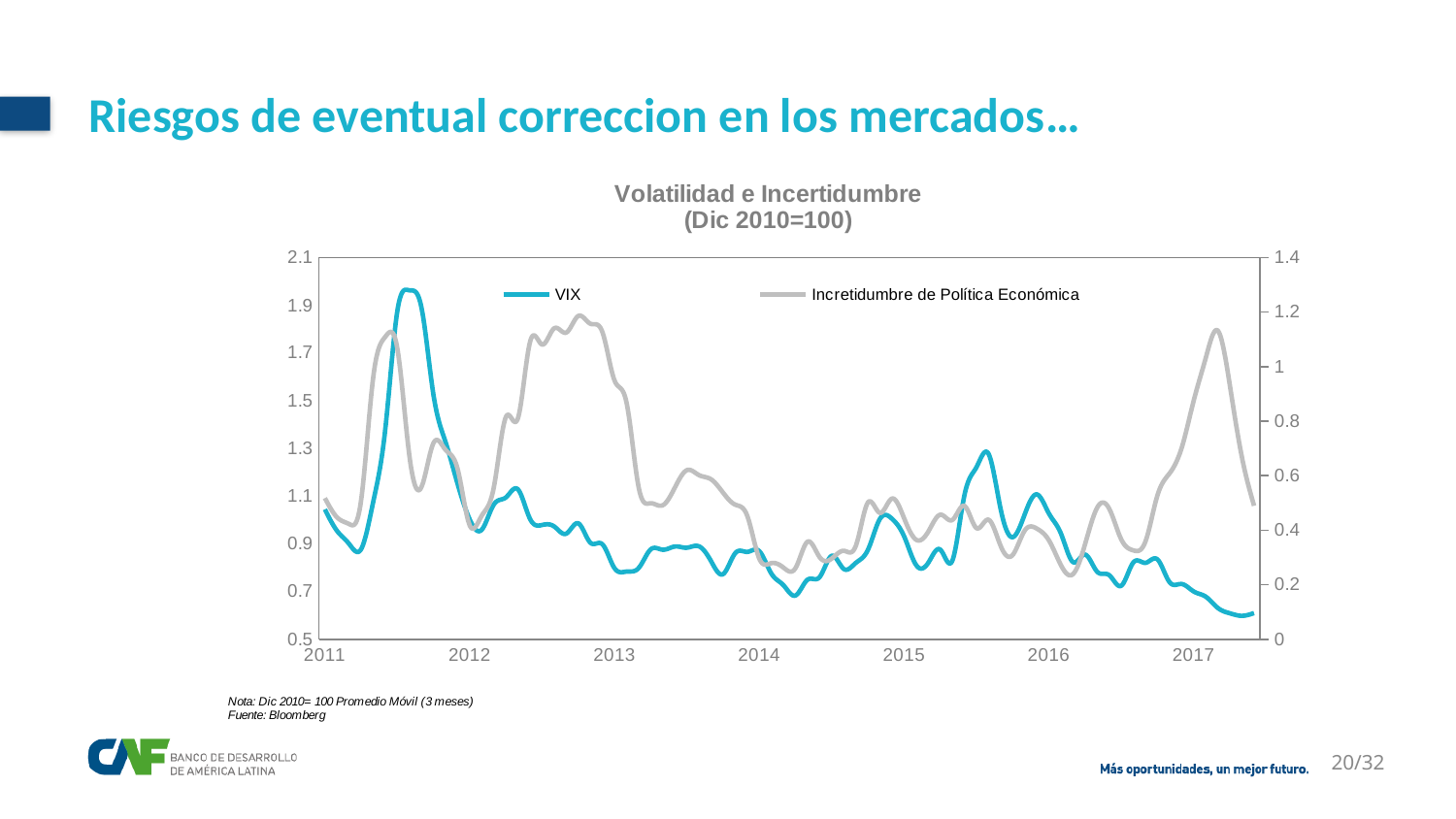
What kind of chart is shown on the slide? Line chart Reading the left-hand axis, is the VIX value at its 2011 peak greater or less than 1.5? greater Which series is drawn in blue? VIX In which year does the VIX line reach its highest point? 2011 How many series does the legend list? 2 Does the VIX line rise or fall between 2016 and 2017? Fall What is the highest value shown on the right-hand axis? 1.4 What is the title of the chart? Volatilidad e Incertidumbre (Dic 2010=100) What is the highest value shown on the left-hand axis? 2.1 How many year labels are shown on the x axis? 7 Reading the left-hand axis, is the VIX value at the end of the series in 2017 greater or less than 0.7? less